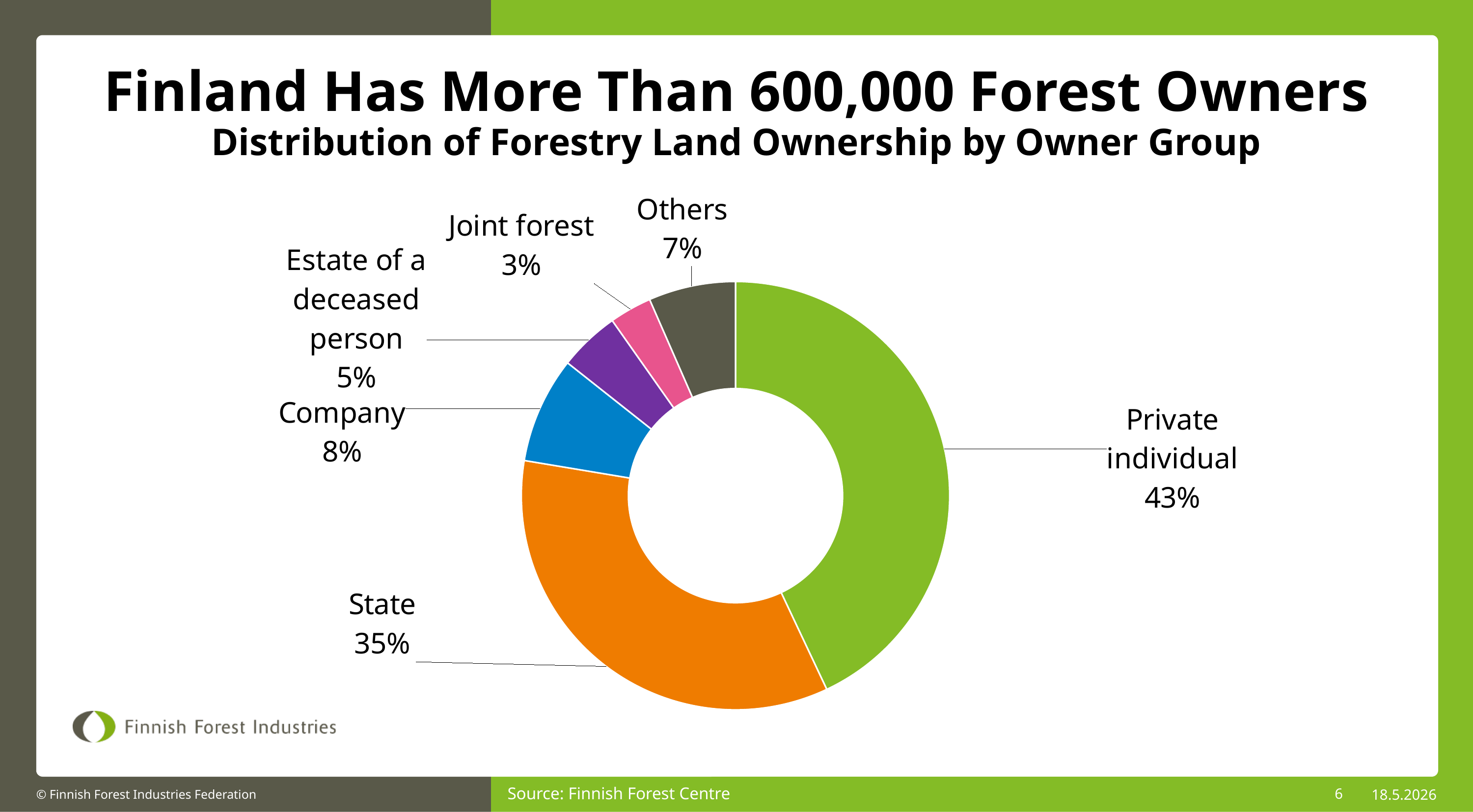
What colour is the State slice in the chart? Orange What share of forestry land ownership belongs to companies? 8% Which owner group has the largest share of forestry land ownership? Private individual What share of forestry land ownership belongs to the State? 35% What kind of chart is shown on the slide? Pie chart (doughnut) What share of forestry land ownership is held by joint forests? 3% How many percentage points larger is the private individual share than the State share? 8 Which owner group has the smallest share of forestry land ownership? Joint forest What share of forestry land ownership is held by estates of deceased persons? 5% What share of forestry land ownership belongs to private individuals? 43% Which owner group has a larger share: Company or Others? Company How many owner groups are shown in the chart? 6